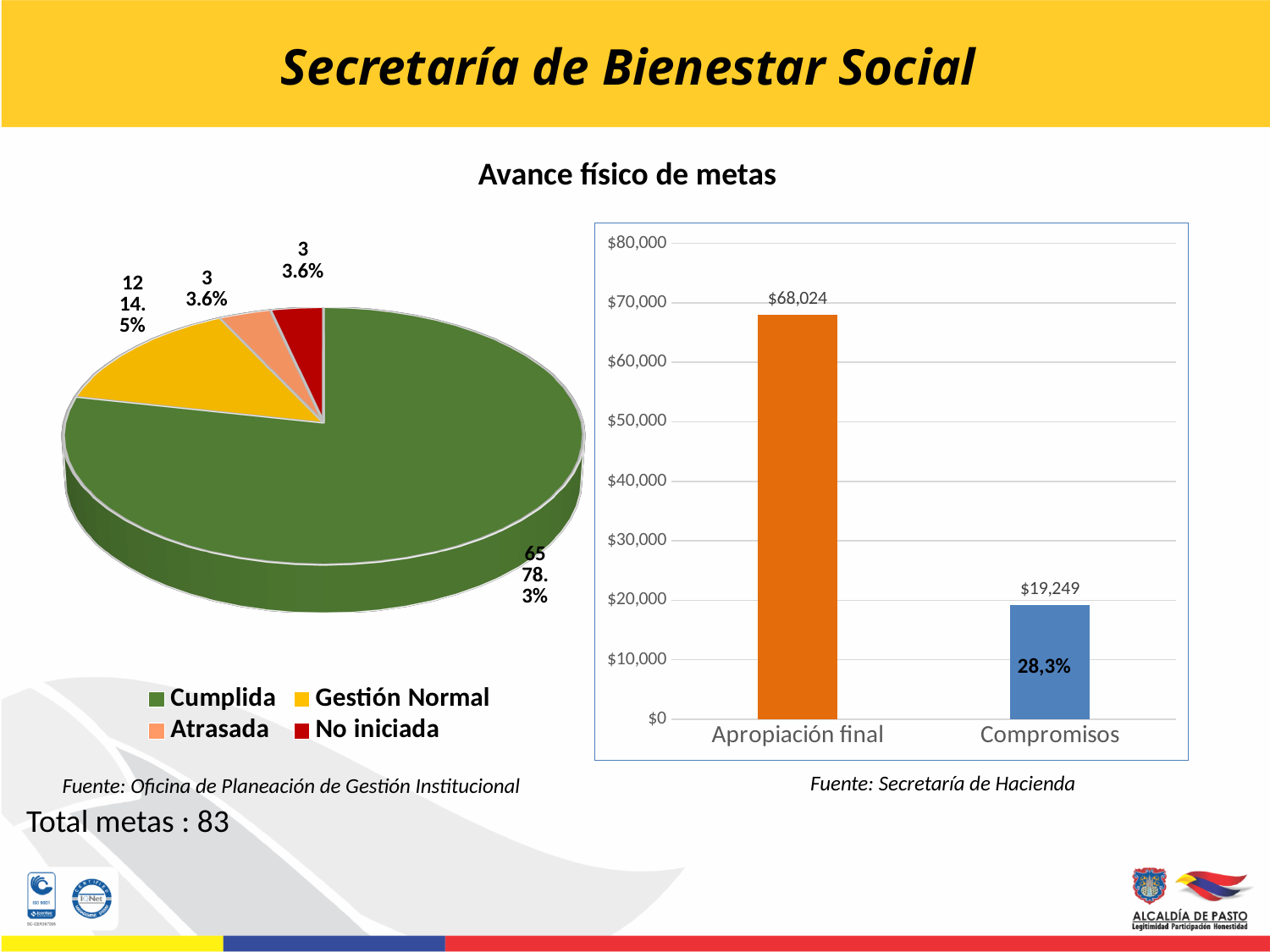
In the bar chart on the right, what is the value for Apropiación final? $68,024 In the pie chart on the left, how many categories does the legend list? 4 In the pie chart on the left, which category has the largest slice? Cumplida In the pie chart on the left, how many metas are labelled Cumplida? 65 In the pie chart on the left, how many metas are labelled Gestión Normal? 12 In the bar chart on the right, what is the difference between Apropiación final and Compromisos? $48,775 In the pie chart on the left, what percentage share does the Gestión Normal slice have? 14.5% What kind of chart is shown on the right side of the slide? Bar chart In the pie chart on the left, what is the difference between the Cumplida count and the Gestión Normal count? 53 In the bar chart on the right, what is the value for Compromisos? $19,249 In the pie chart on the left, what percentage share does the Cumplida slice have? 78.3% In the bar chart on the right, which category has the higher value, Apropiación final or Compromisos? Apropiación final